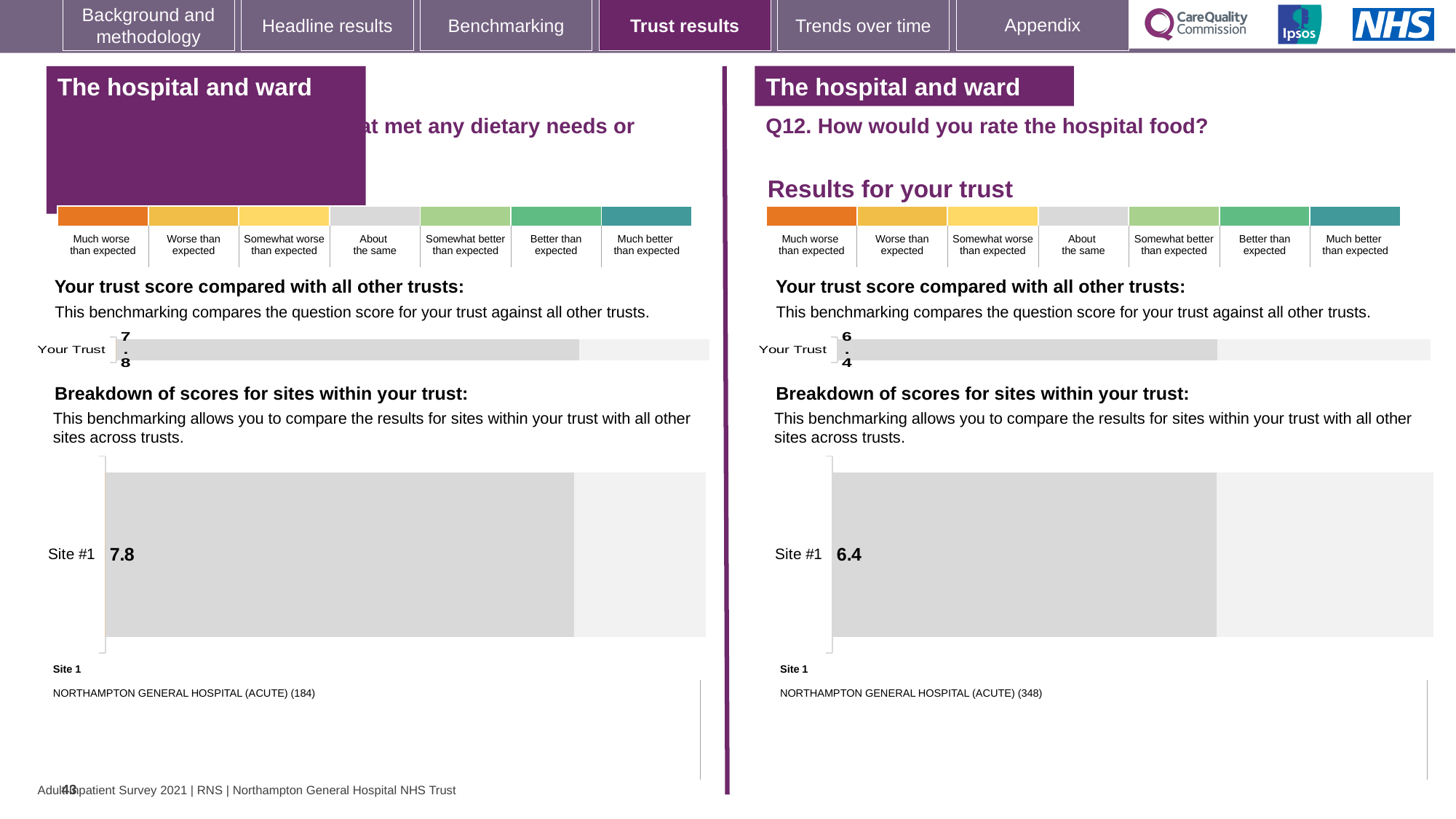
On the left-hand side of the slide, what is the score shown for Your Trust? 7.8 Is the Your Trust score on the right-hand side of the slide (Q12) greater or less than 7? less What is the difference between the Your Trust score on the left-hand side of the slide and the Your Trust score on the right-hand side (Q12)? 1.4 How many sites are listed in the breakdown of scores for sites within your trust on the right-hand side of the slide (Q12)? 1 What kind of chart is used to show the Site #1 score on the right-hand side of the slide (Q12)? Bar chart On the left-hand side of the slide, which site is listed as Site 1? NORTHAMPTON GENERAL HOSPITAL (ACUTE) (184) On the right-hand side of the slide (Q12), what is the score shown for Site #1 in the breakdown of scores for sites within your trust? 6.4 On the right-hand side of the slide (Q12. How would you rate the hospital food?), what is the score shown for Your Trust? 6.4 Which is larger: the Site #1 score on the left-hand side of the slide or the Site #1 score on the right-hand side (Q12)? Left-hand side (7.8) Is the Site #1 score on the left-hand side of the slide greater or less than 7? greater On the right-hand side of the slide (Q12), which site is listed as Site 1? NORTHAMPTON GENERAL HOSPITAL (ACUTE) (348) On the left-hand side of the slide, what is the score shown for Site #1 in the breakdown of scores for sites within your trust? 7.8